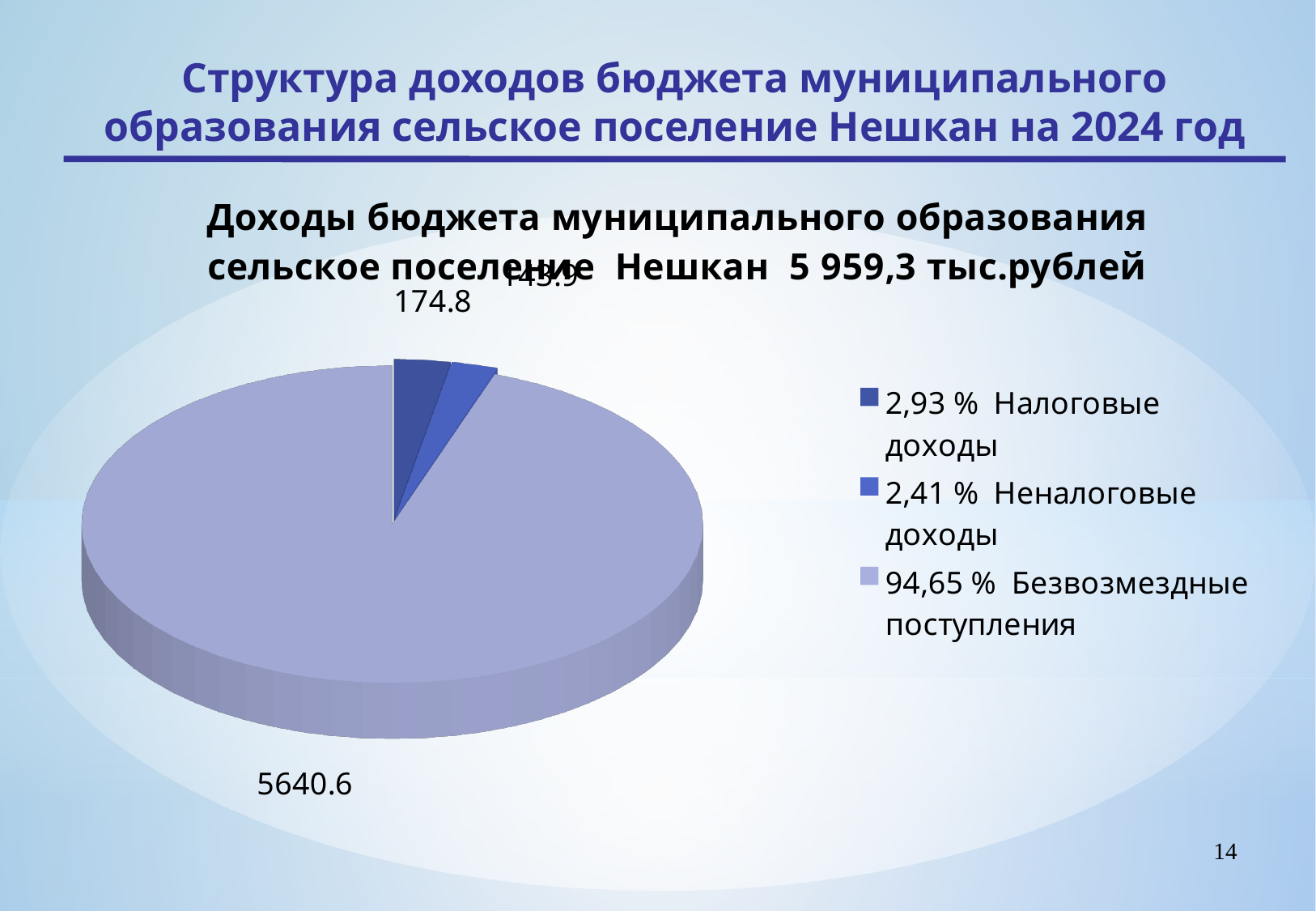
Which category has the largest slice of the pie? Безвозмездные поступления What share of the pie do Безвозмездные поступления make up? 94,65 % What share of the pie do Неналоговые доходы make up? 2,41 % Which is larger, Налоговые доходы or Неналоговые доходы? Налоговые доходы What share of the pie do Налоговые доходы make up? 2,93 % What kind of chart is shown on the slide? pie chart What is the value shown for Безвозмездные поступления? 5640.6 How many slices does the pie chart have? 3 What is the difference between the values for Безвозмездные поступления and Налоговые доходы? 5465.8 What is the value shown for Налоговые доходы? 174.8 Which category has the smallest slice of the pie? Неналоговые доходы How many entries does the legend list? 3